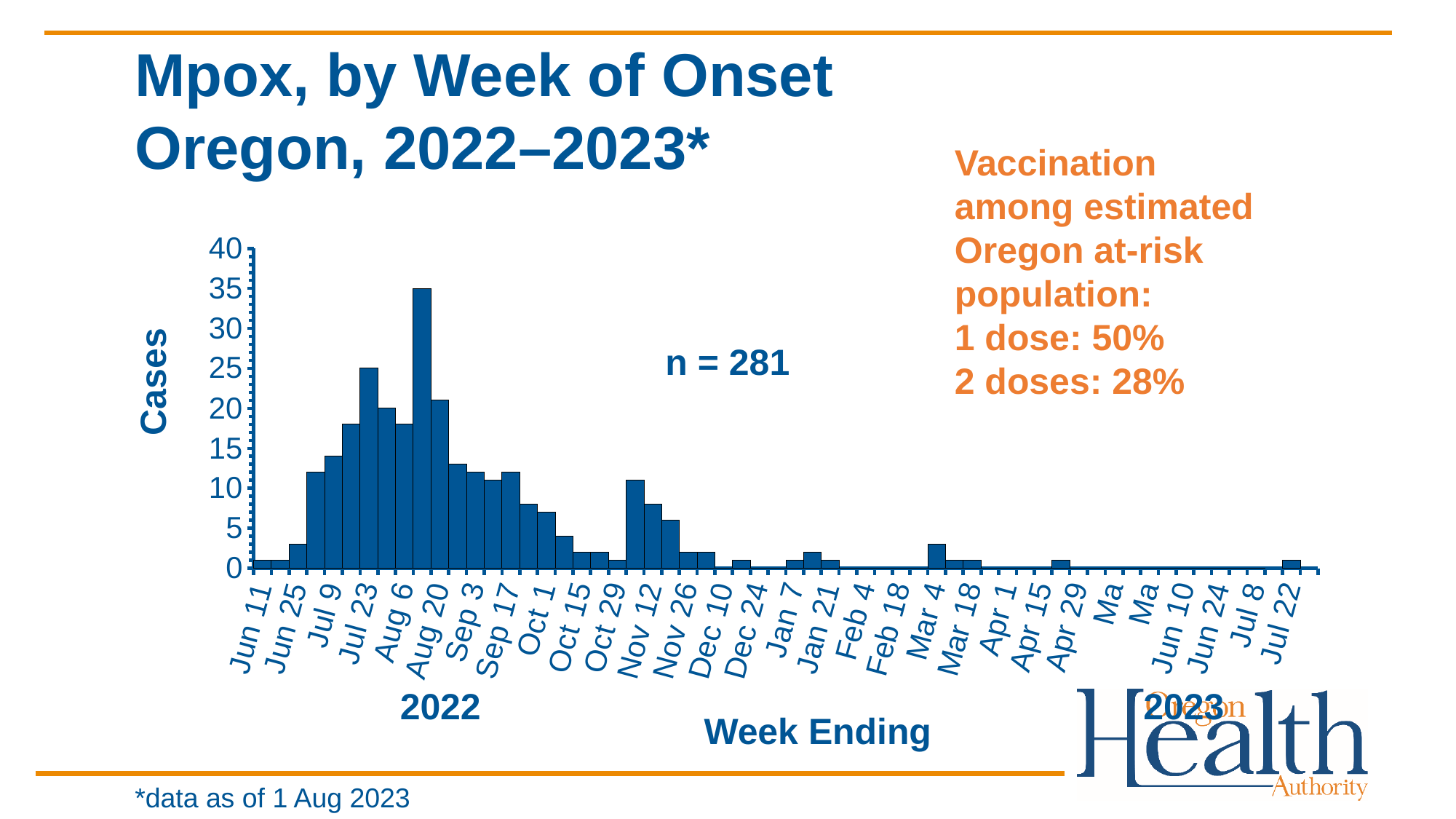
What total number of cases (n) is printed on the chart? n = 281 What is the title of the chart? Mpox, by Week of Onset Oregon, 2022–2023* Is the number of cases for the week ending Jul 9 greater or less than 10? greater In which month does the highest bar on the chart occur? August What is the label on the vertical axis of the chart? Cases Between the weeks ending Jun 11 and Jul 23, do the weekly case counts generally rise or fall? rise Is the number of cases for the week ending Jul 23 greater or less than 20? greater What kind of chart is shown on the slide? bar chart Is the number of cases for the week ending Oct 1 greater or less than 5? greater Between the weeks ending Aug 20 and Oct 29, do the weekly case counts generally rise or fall? fall